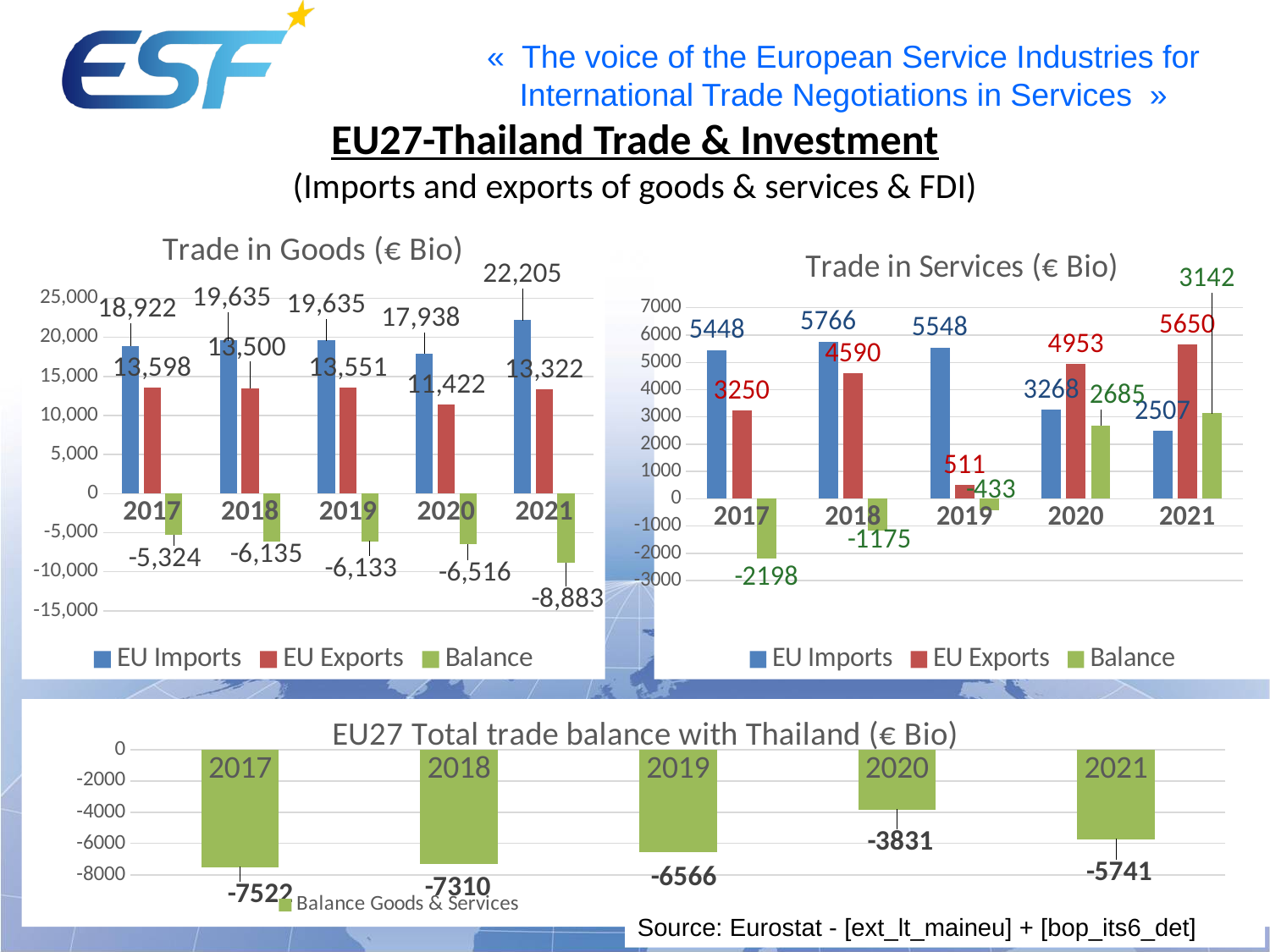
In the Trade in Goods (€ Bio) chart, what is the value of EU Imports in 2021? 22,205 In the Trade in Services (€ Bio) chart, what is the value of EU Exports in 2021? 5650 In the Trade in Goods (€ Bio) chart, which year has the lowest Balance? 2021 How many years are shown in the EU27 Total trade balance with Thailand (€ Bio) chart? 5 How many series does the legend of the Trade in Goods (€ Bio) chart list? 3 What kind of chart is the EU27 Total trade balance with Thailand (€ Bio) chart? bar chart In the EU27 Total trade balance with Thailand (€ Bio) chart, what is the value for 2020? -3831 In the Trade in Services (€ Bio) chart, which is larger in 2017, EU Imports or EU Exports? EU Imports In the Trade in Services (€ Bio) chart, what is the Balance in 2020? 2685 In the EU27 Total trade balance with Thailand (€ Bio) chart, which year has the highest (least negative) balance? 2020 In the Trade in Goods (€ Bio) chart, what is the difference between EU Imports and EU Exports in 2017? 5,324 In the Trade in Services (€ Bio) chart, which year has the highest EU Imports? 2018